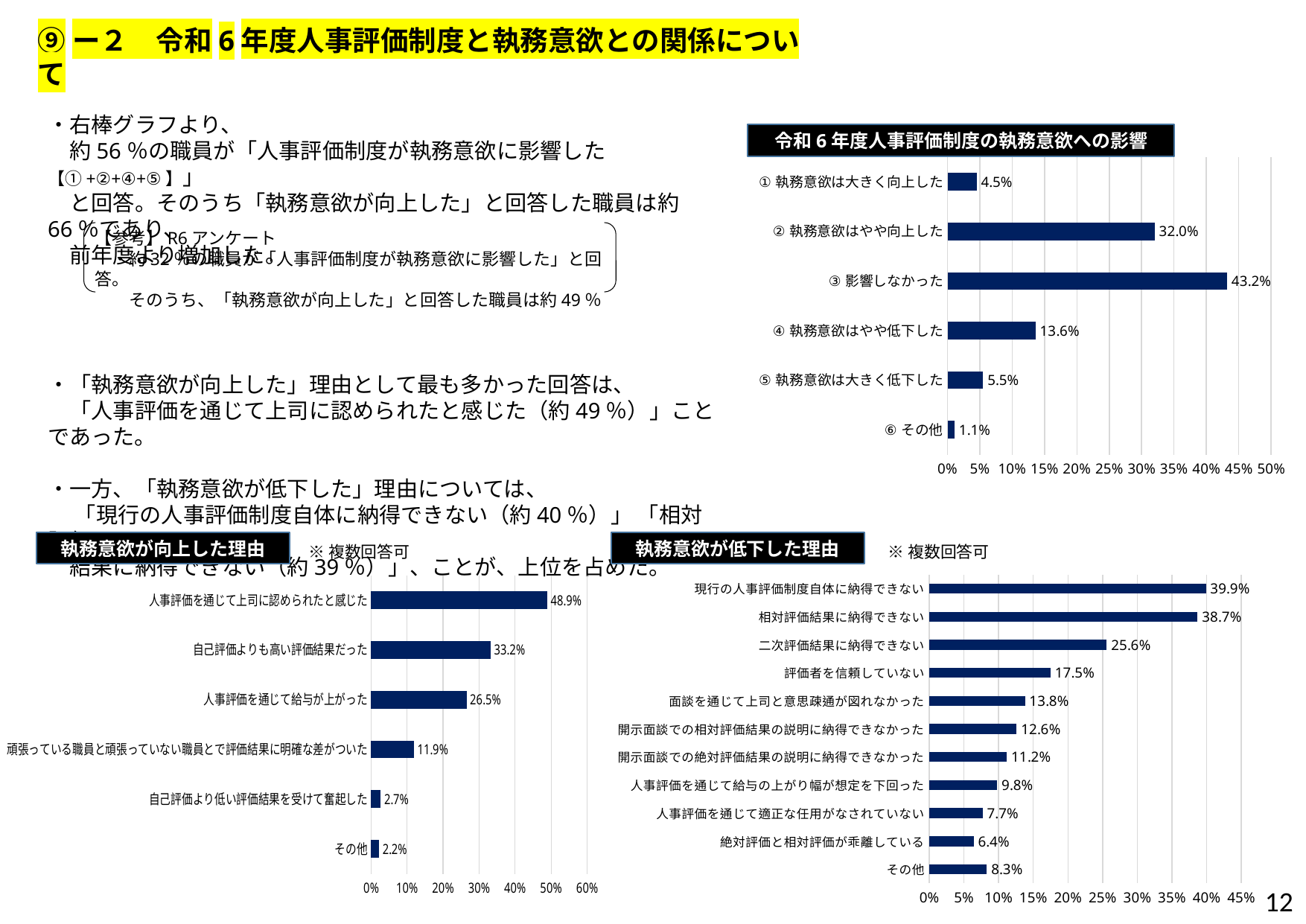
In the chart titled 令和6年度人事評価制度の執務意欲への影響, which category has the lowest value? ⑥ その他 What kind of chart is the one titled 執務意欲が向上した理由? Bar chart In the chart titled 令和6年度人事評価制度の執務意欲への影響, what is the value for ③ 影響しなかった? 43.2% In the chart titled 執務意欲が向上した理由, which is larger: 自己評価よりも高い評価結果だった or 頑張っている職員と頑張っていない職員とで評価結果に明確な差がついた? 自己評価よりも高い評価結果だった In the chart titled 執務意欲が向上した理由, which category has the highest value? 人事評価を通じて上司に認められたと感じた In the chart titled 執務意欲が低下した理由, what is the value for 評価者を信頼していない? 17.5% In the chart titled 執務意欲が低下した理由, which category has the lowest value? 絶対評価と相対評価が乖離している In the chart titled 令和6年度人事評価制度の執務意欲への影響, how many categories are shown? 6 In the chart titled 執務意欲が低下した理由, how many categories are shown? 11 In the chart titled 令和6年度人事評価制度の執務意欲への影響, what is the difference between ② 執務意欲はやや向上した and ④ 執務意欲はやや低下した? 18.4% In the chart titled 執務意欲が向上した理由, what is the value for 人事評価を通じて給与が上がった? 26.5% In the chart titled 執務意欲が低下した理由, what is the difference between 現行の人事評価制度自体に納得できない and 二次評価結果に納得できない? 14.3%